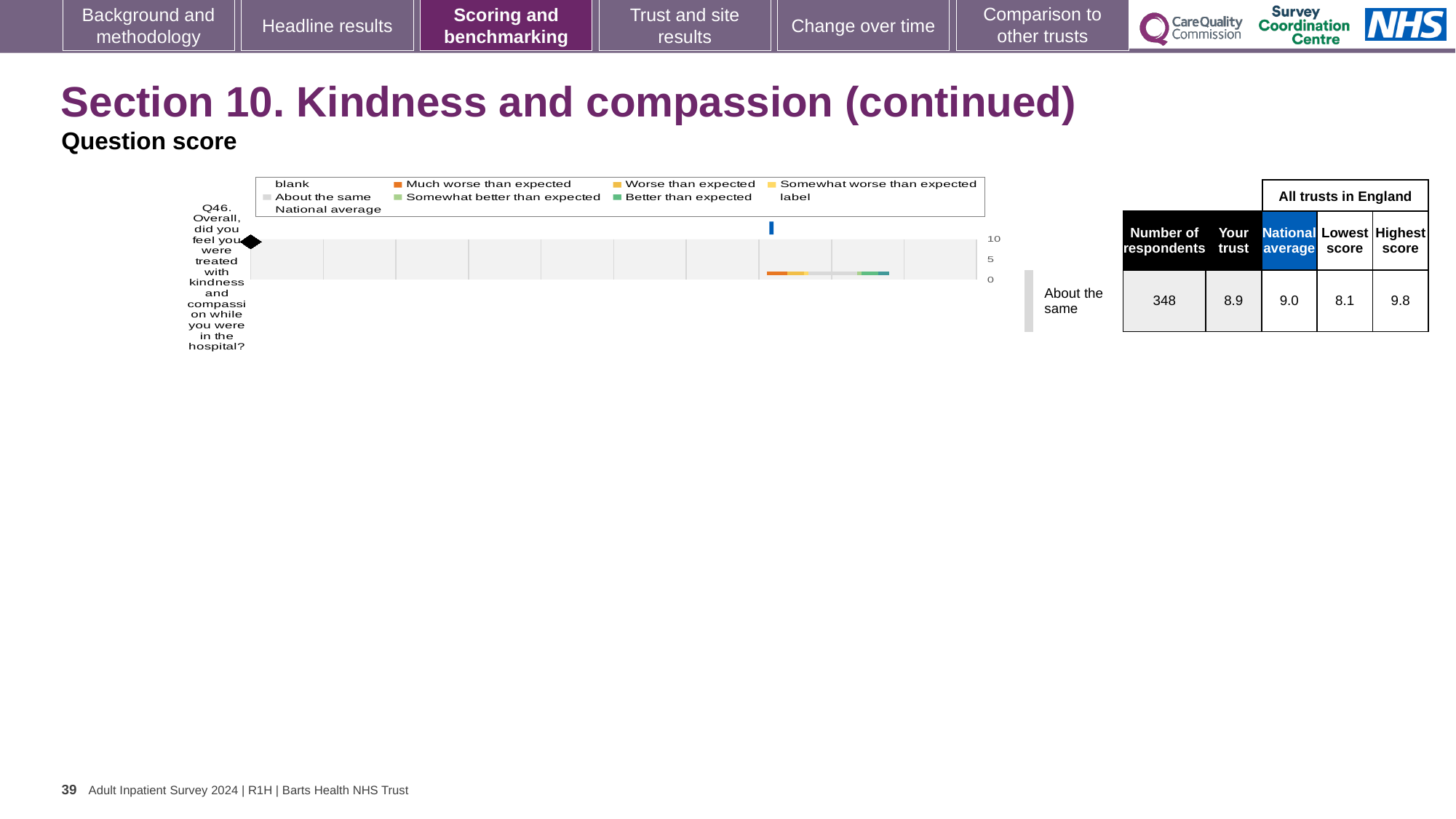
What is the highest tick value shown on the chart's axis? 10 According to the table next to the chart, what is the National average score for Q46? 9.0 According to the table next to the chart, what is the Lowest score among all trusts in England for Q46? 8.1 Which is larger for Q46, the 'Your trust' score or the National average? National average What is the difference between the Highest score and the Lowest score for Q46 in the table? 1.7 According to the table next to the chart, what is the 'Your trust' score for Q46? 8.9 How many question categories are plotted on the chart? 1 What kind of chart is shown on the slide? Bar chart According to the table next to the chart, how many respondents answered Q46? 348 According to the table next to the chart, what is the Highest score among all trusts in England for Q46? 9.8 What benchmark category is the trust's Q46 score assigned to, as labelled beside the chart? About the same Which question number is plotted on the chart? Q46